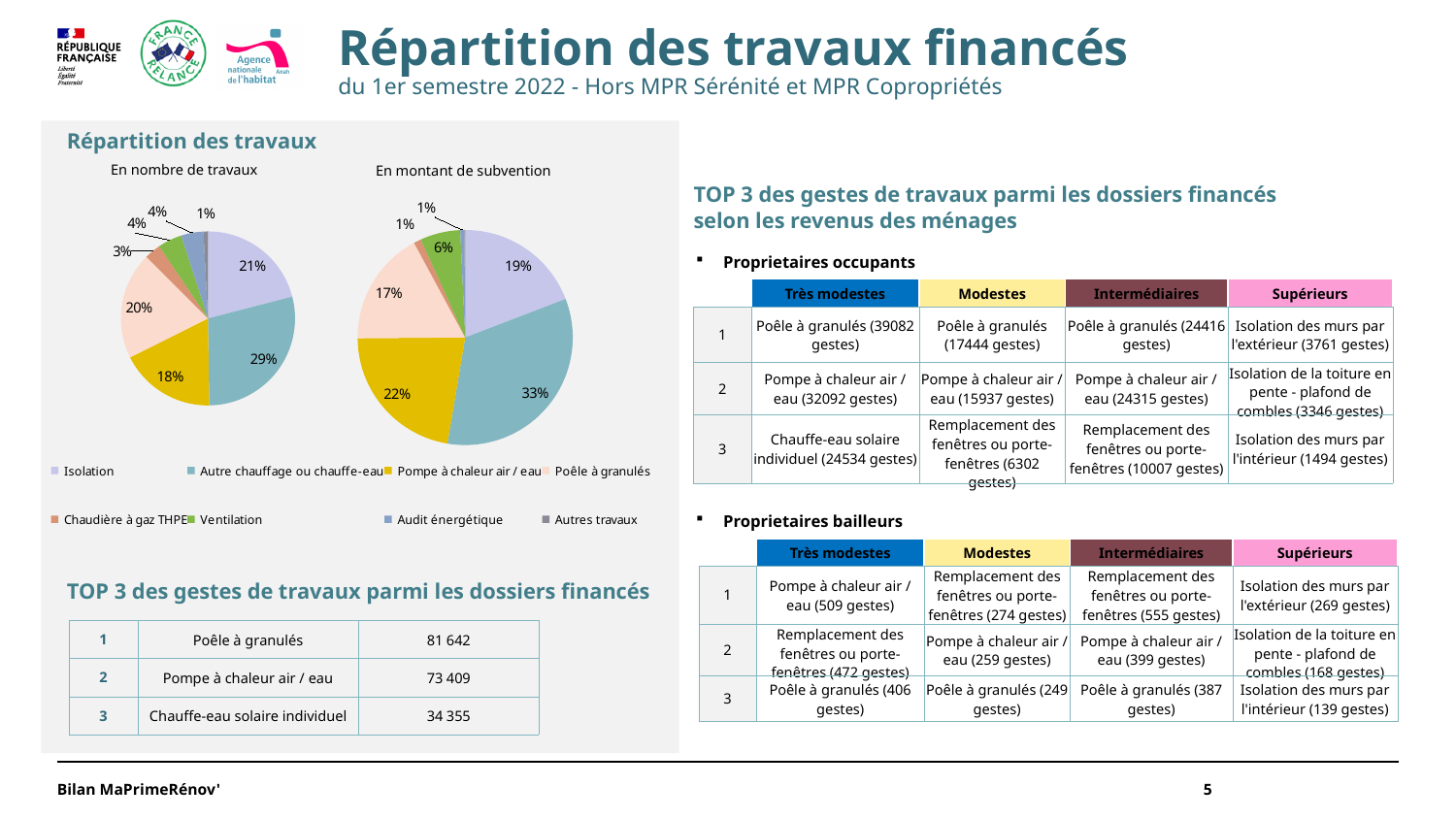
In the 'En montant de subvention' pie chart, what share is shown for Poêle à granulés? 17% How many categories does the legend of the pie charts list? 8 In the 'En montant de subvention' pie chart, which category has the largest share? Autre chauffage ou chauffe-eau In the 'En nombre de travaux' pie chart, what share is shown for Ventilation? 4% In the 'En nombre de travaux' pie chart, what is the difference between the shares of Autre chauffage ou chauffe-eau and Pompe à chaleur air / eau? 11 percentage points In the 'En montant de subvention' pie chart, which is larger: the share for Isolation or the share for Poêle à granulés? Isolation What are the titles of the two pie charts under 'Répartition des travaux'? En nombre de travaux and En montant de subvention What type of chart is used to show the 'Répartition des travaux'? Pie chart In the 'En nombre de travaux' pie chart, what share is shown for Isolation? 21% In the 'En nombre de travaux' pie chart, what share is shown for Autre chauffage ou chauffe-eau? 29% In the 'En montant de subvention' pie chart, what share is shown for Pompe à chaleur air / eau? 22% In the 'En nombre de travaux' pie chart, which category has the smallest share? Autres travaux